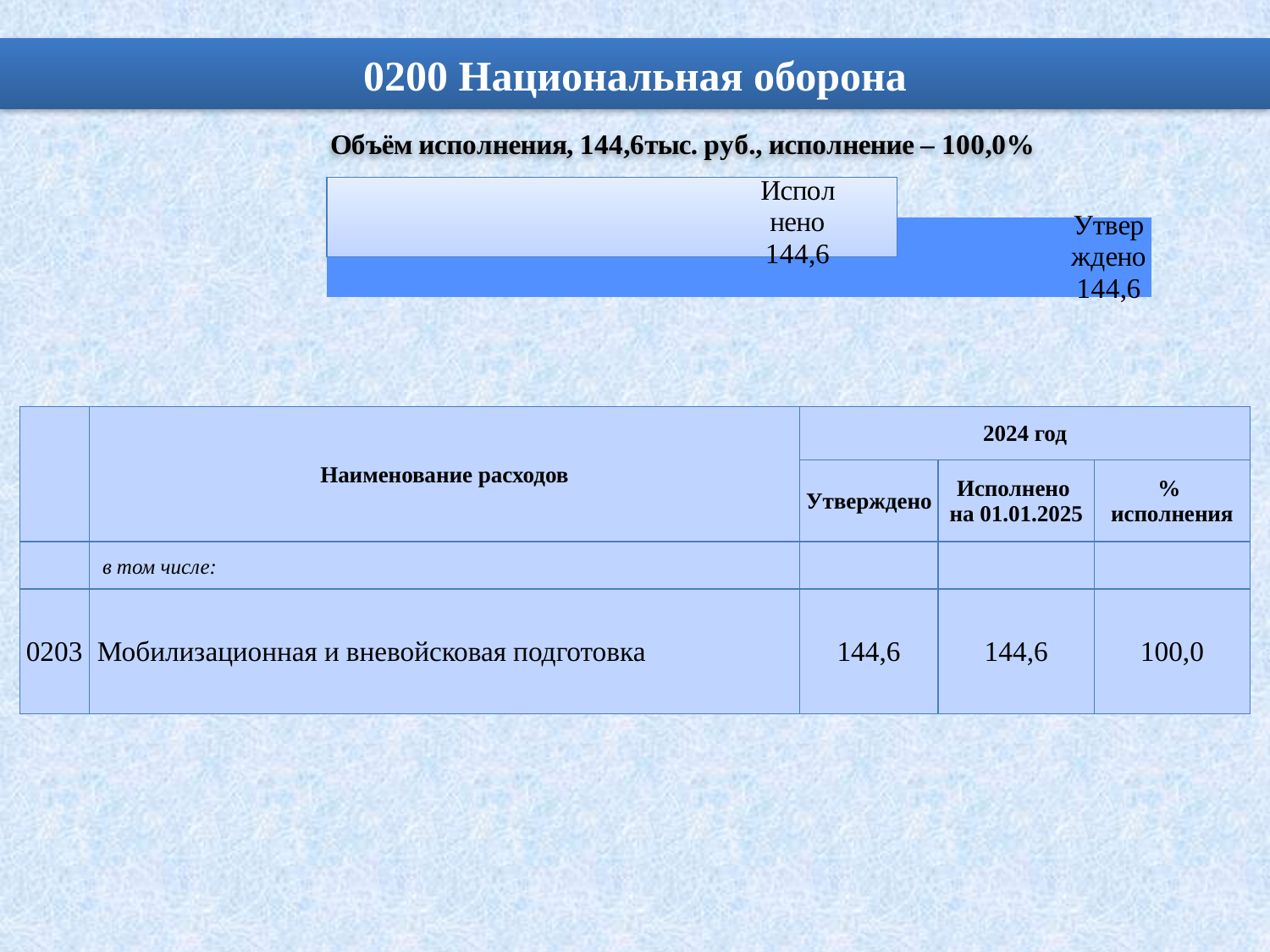
How many bars are plotted in the chart? 2 Are the bars in the chart horizontal or vertical? horizontal What is the value of the bar labelled "Исполнено"? 144,6 What is the text shown above the chart describing the volume of execution? Объём исполнения, 144,6тыс. руб., исполнение – 100,0% What is the value of the bar labelled "Утверждено"? 144,6 What is the difference between the "Утверждено" and "Исполнено" values in the chart? 0,0 What kind of chart is shown on the slide? bar chart